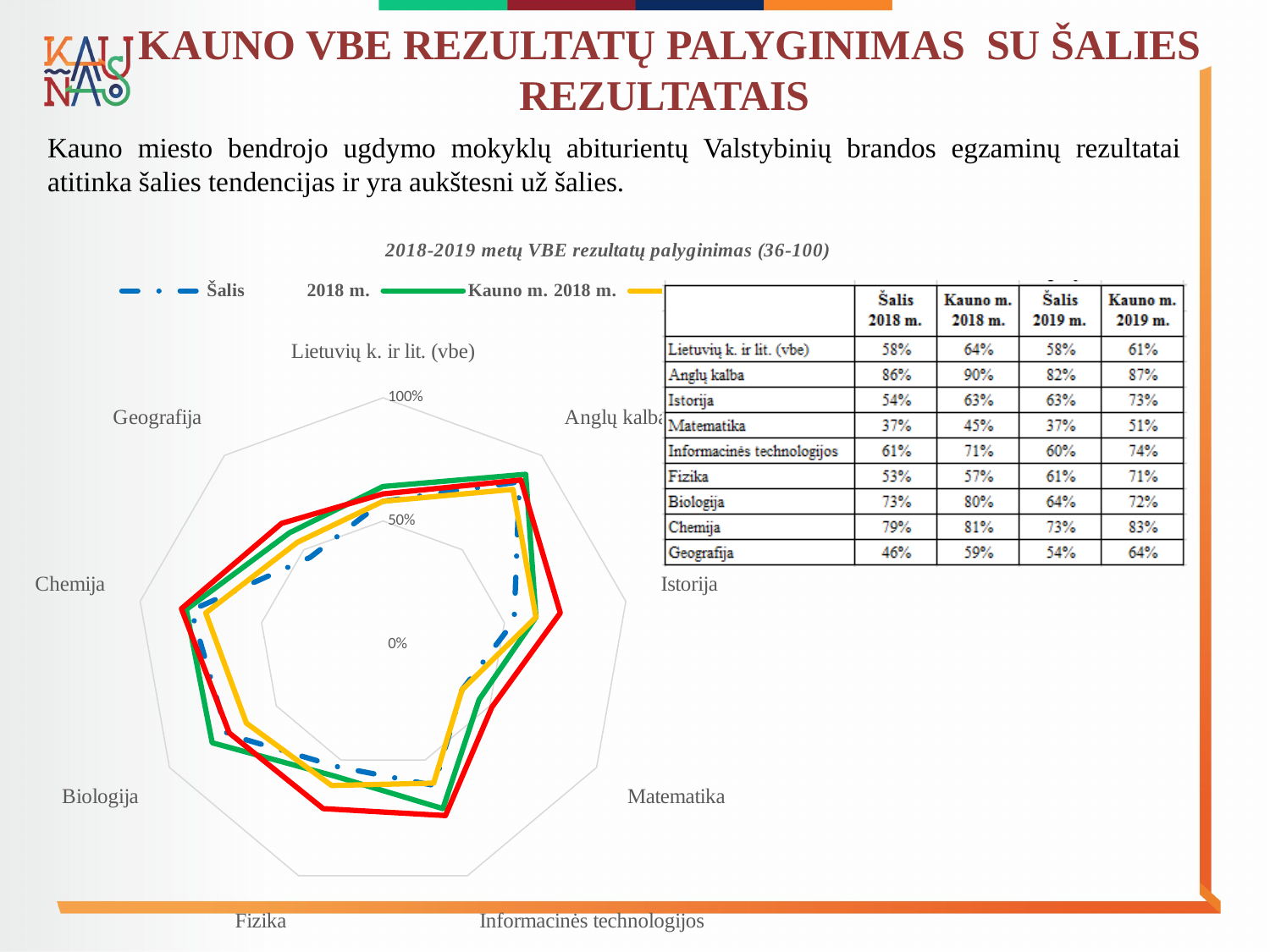
Which subject has the lowest Šalis 2019 m. value? Matematika Which is larger for Geografija: the Kauno m. 2018 m. value or the Šalis 2018 m. value? Kauno m. 2018 m. What is the Kauno m. 2018 m. value for Biologija? 80% What is the difference between the Kauno m. 2019 m. and Šalis 2019 m. values for Istorija? 10% What is the title of the chart? 2018-2019 metų VBE rezultatų palyginimas (36-100) What is the Šalis 2019 m. value for Fizika? 61% What is the Šalis 2018 m. value for Anglų kalba? 86% What kind of chart is shown on the slide? radar chart Which subject has the highest Kauno m. 2019 m. value? Anglų kalba Is the Šalis 2018 m. value for Matematika greater or less than 50%? less How many subject categories are plotted on the radar chart? 9 What is the Kauno m. 2019 m. value for Matematika? 51%